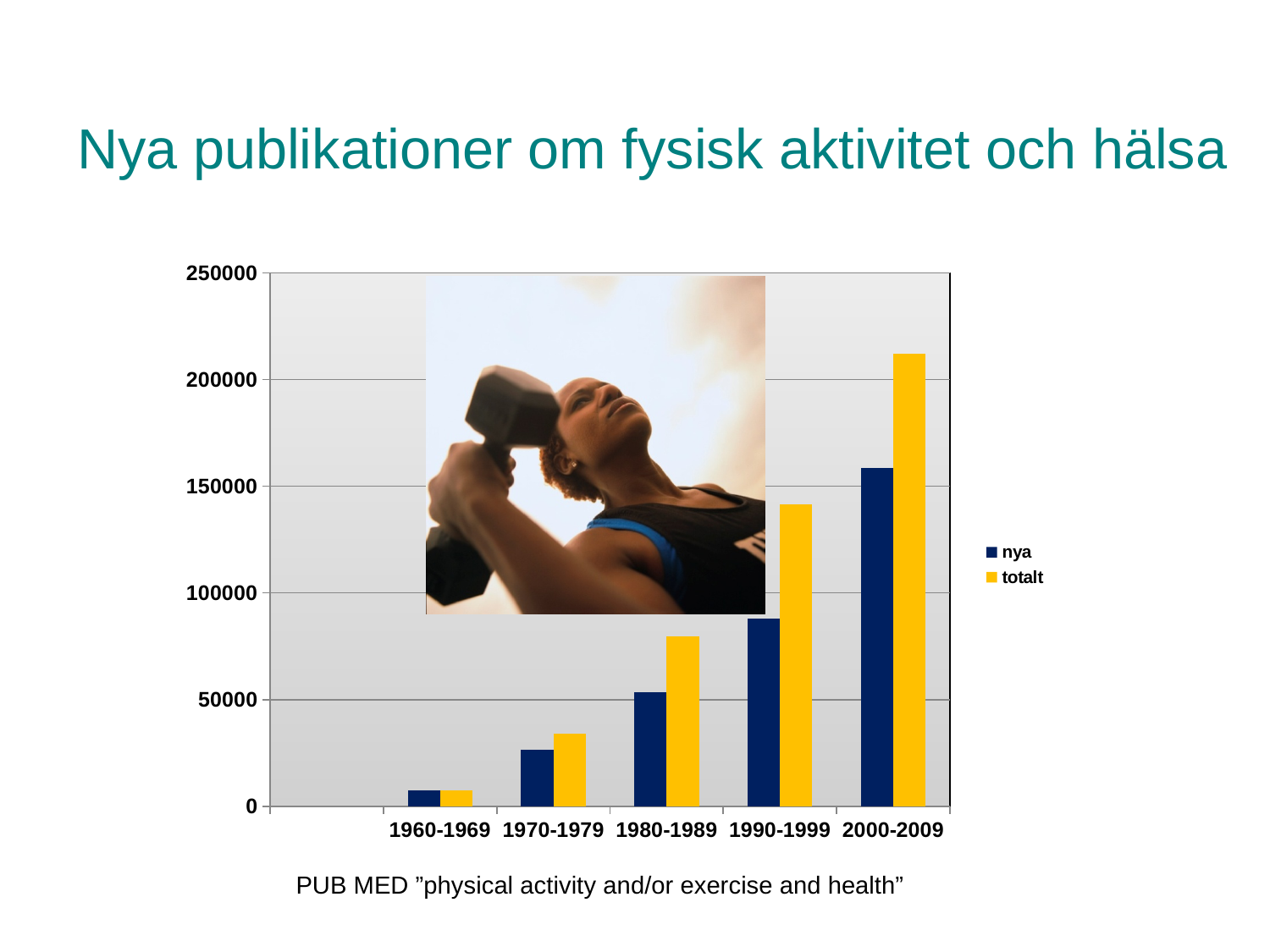
Which colour represents the totalt series? yellow Is the value for totalt in 1980-1989 greater or less than 50000? greater How many series does the legend list? 2 Do the values for nya rise or fall from 1960-1969 to 2000-2009? rise What kind of chart is shown on the slide? bar chart Which is larger in 1990-1999, nya or totalt? totalt How many decade categories are shown on the x axis? 5 What are the two series named in the legend? nya and totalt Is the value for nya in 1990-1999 greater or less than 100000? less Which decade has the lowest value for nya? 1960-1969 Is the value for totalt in 2000-2009 greater or less than 200000? greater Which decade has the highest value for totalt? 2000-2009